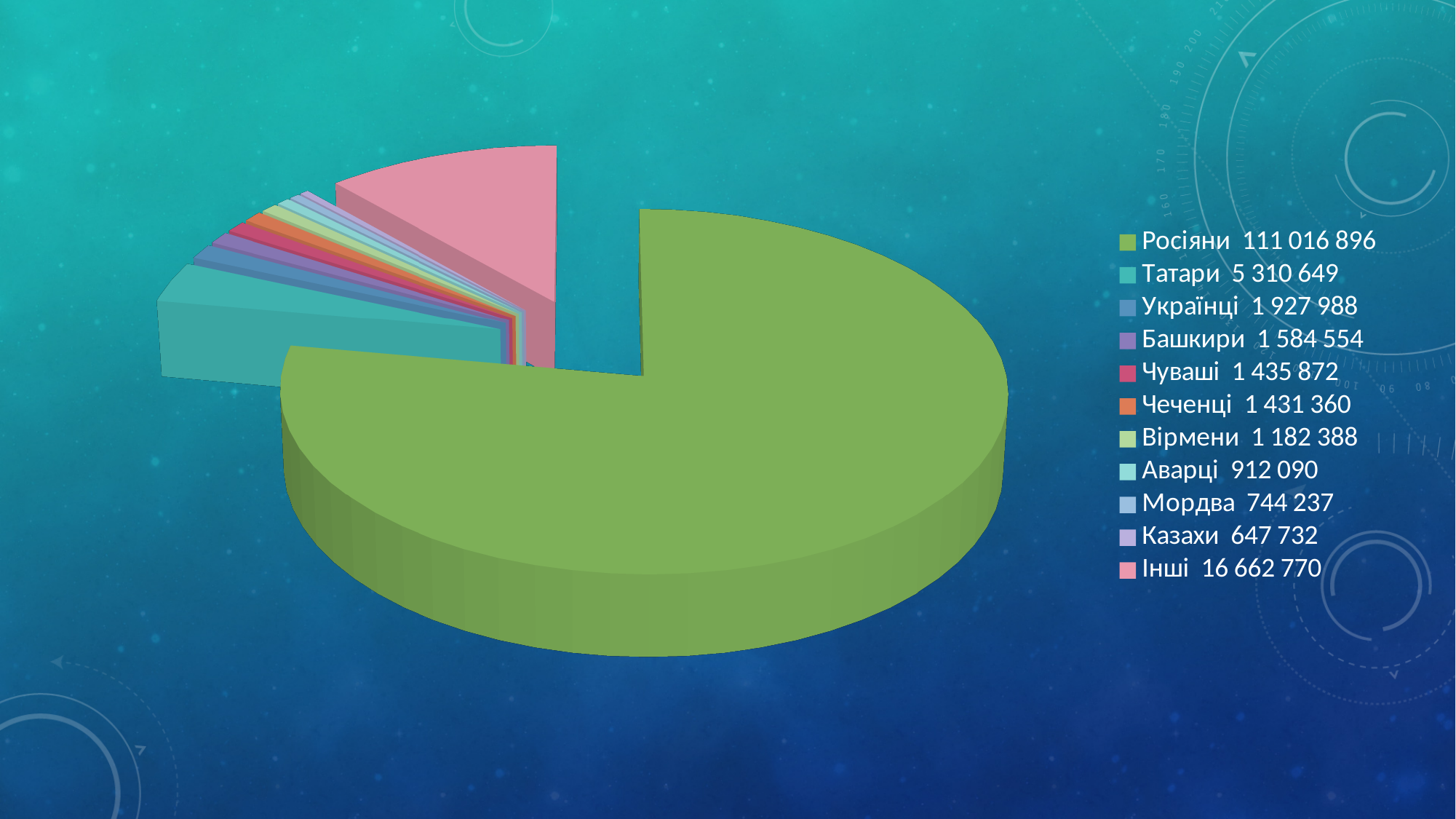
What is the difference between the values for Мордва and Казахи? 96 505 What is the value for Татари? 5 310 649 Which category has the largest value? Росіяни Which category has the smallest value? Казахи What is the difference between the values for Татари and Українці? 3 382 661 Which is larger, Інші or Татари? Інші What is the value for Росіяни? 111 016 896 How many categories does the pie chart have? 11 What colour is the slice for Росіяни? green What kind of chart is shown on the slide? pie chart What is the value for Аварці? 912 090 What is the value for Інші? 16 662 770